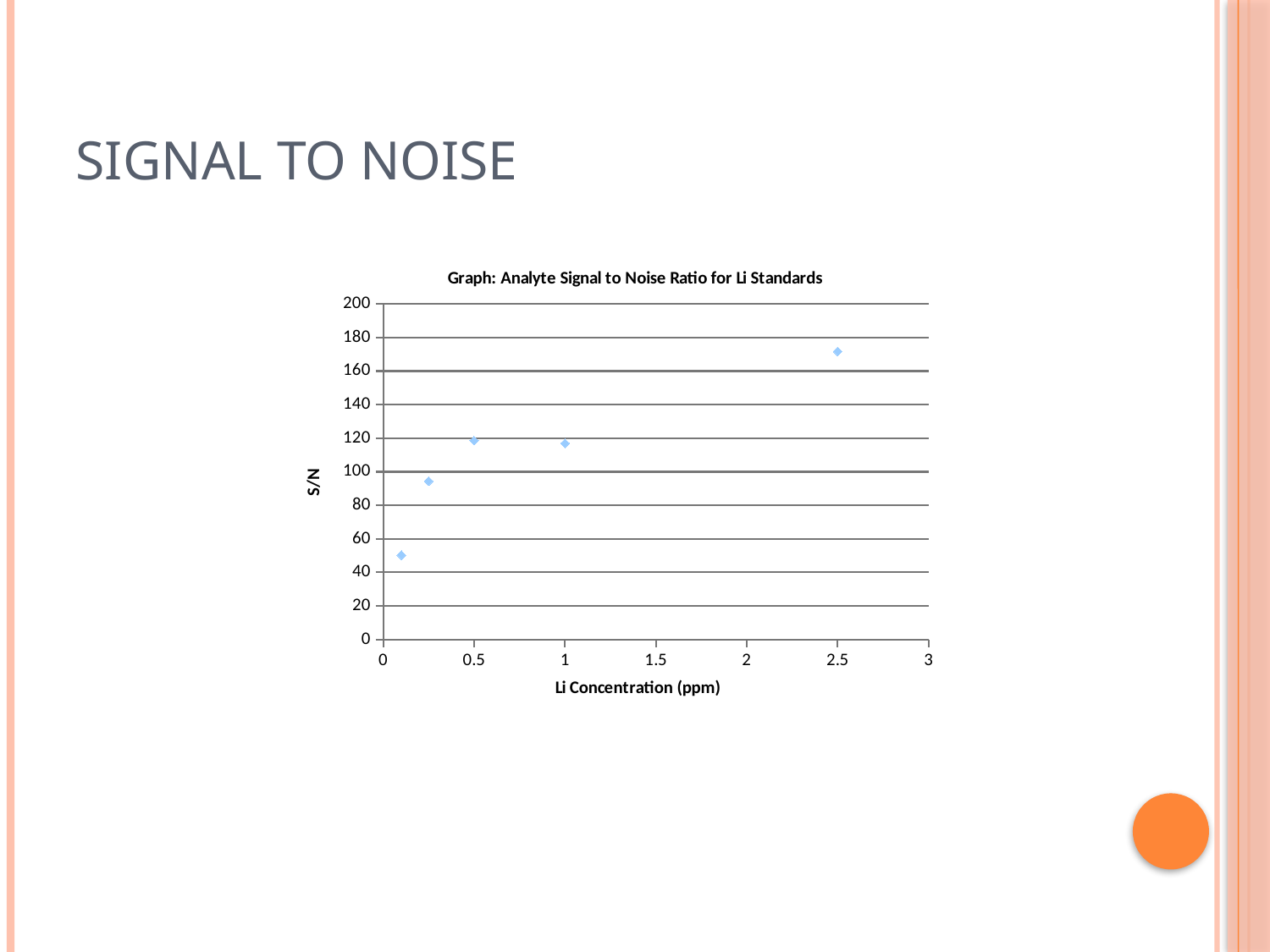
What is the label of the x axis? Li Concentration (ppm) Does the point with the lowest S/N occur at the lowest or the highest Li concentration? lowest concentration Which has the larger S/N: the point at 1 ppm or the point at 2.5 ppm? 2.5 ppm Is the S/N value at 2.5 ppm Li concentration greater or less than 160? greater Is the S/N value at 1 ppm Li concentration greater or less than 100? greater Is the S/N value at 0.5 ppm Li concentration greater or less than 140? less At which Li concentration is the S/N highest? 2.5 ppm Overall, does S/N rise or fall as Li concentration increases? rise What is the title of the chart? Graph: Analyte Signal to Noise Ratio for Li Standards How many data points are plotted on the chart? 5 What kind of chart is shown on the slide? scatter plot